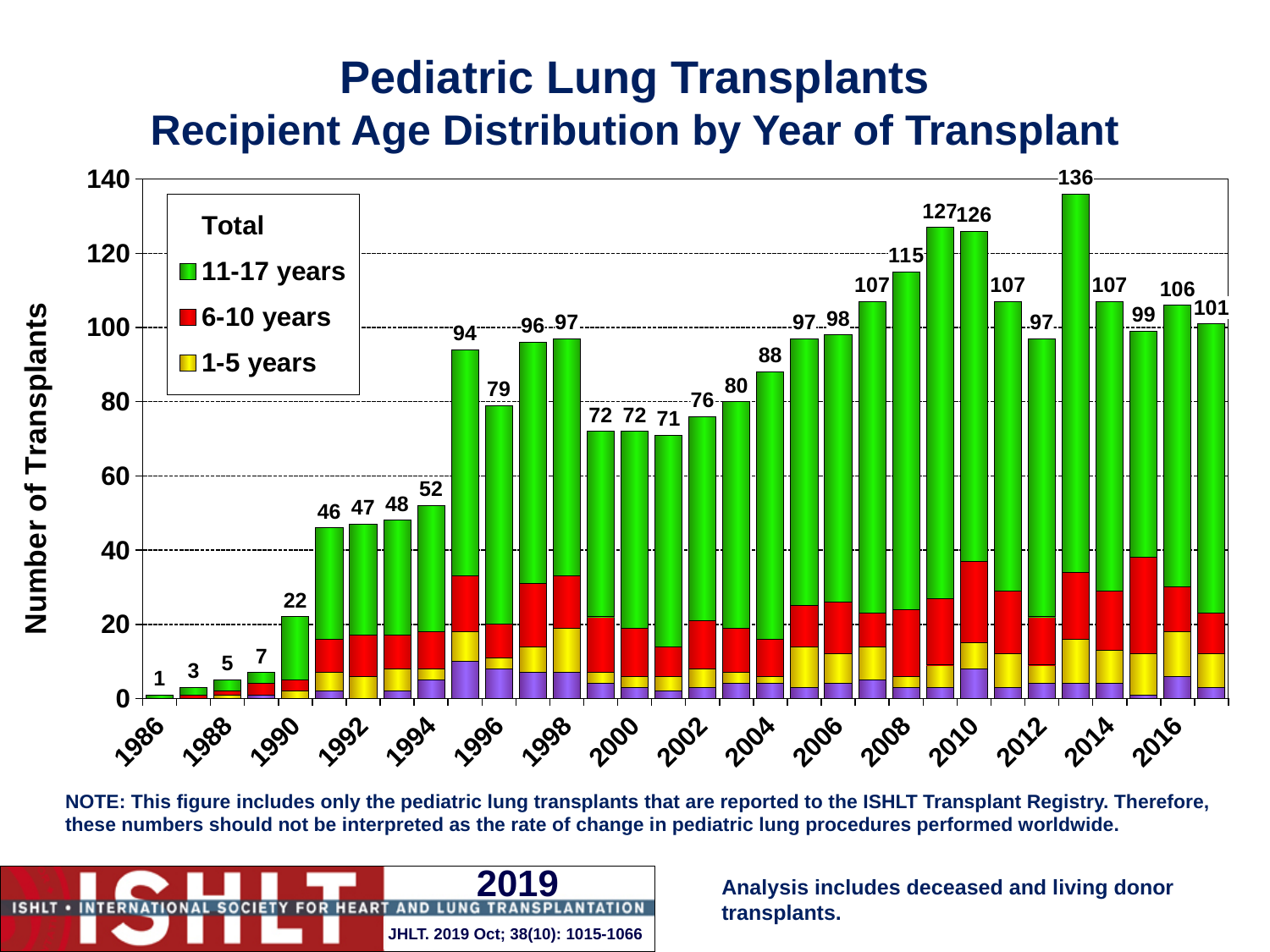
Which age group is shown in green in the chart? 11-17 years What is the difference between the total for 1995 and the total for 1996? 15 Which year has a larger total, 2009 or 2010? 2009 How many age-group series does the legend list? 3 Which year has the highest total number of transplants? 2013 What kind of chart is shown on the slide? Stacked bar chart How many years (bars) are plotted in the chart? 32 What is the difference between the total for 2013 and the total for 2012? 39 What is the total number of pediatric lung transplants shown for 2013? 136 What is the total number of transplants shown for 2009? 127 Which year has the lowest total number of transplants? 1986 What is the total number of transplants shown for 1990? 22